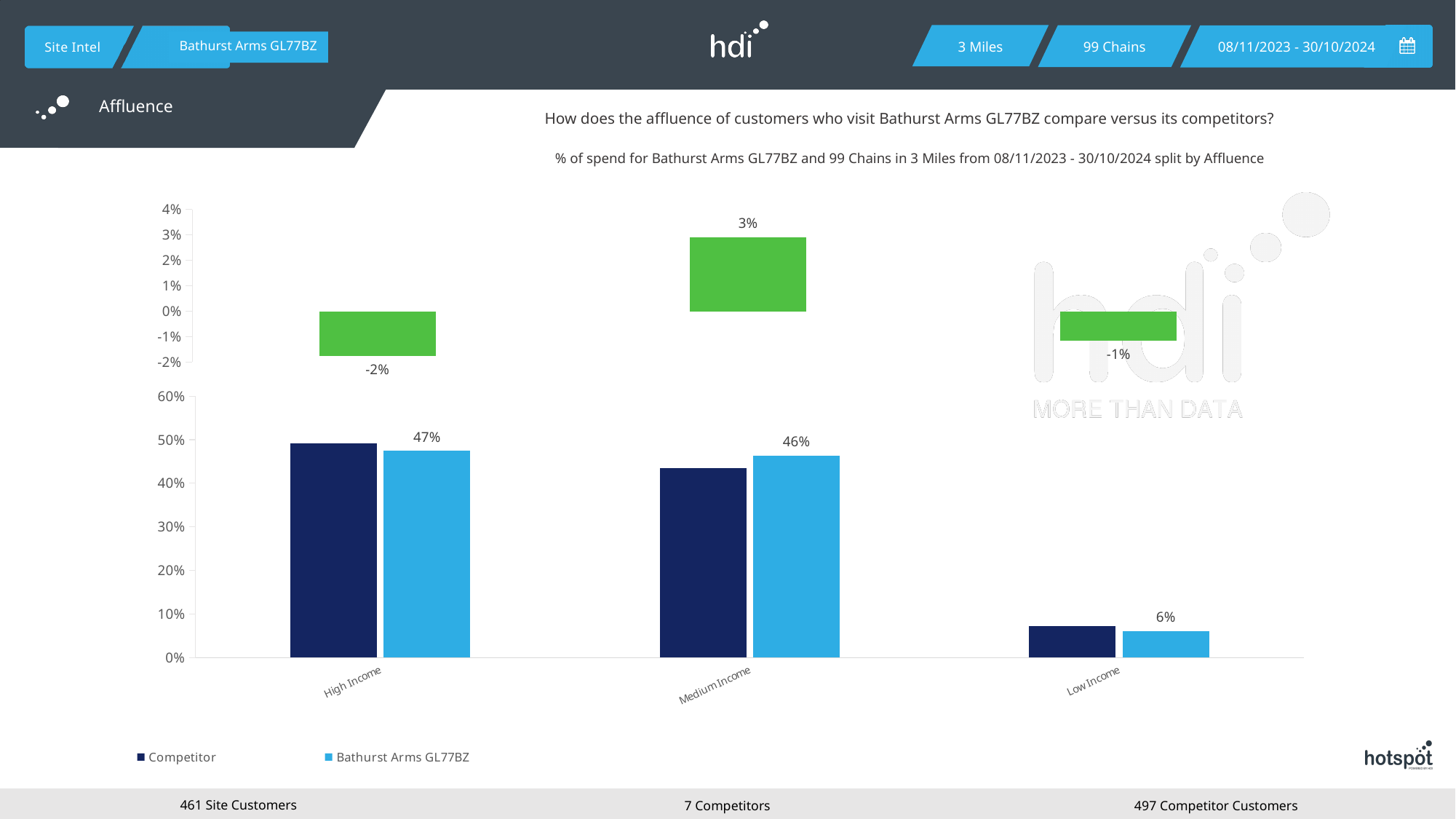
How many categories are shown on the x axis of the bottom bar chart? 3 In the bottom bar chart, is the Competitor value for Low Income greater or less than 10%? less How many series does the legend of the bottom bar chart list? 2 In the bottom bar chart, what is the value for Bathurst Arms GL77BZ in the Medium Income category? 46% In the bottom bar chart, what is the value for Bathurst Arms GL77BZ in the Low Income category? 6% In the bottom bar chart, what is the value for Bathurst Arms GL77BZ in the High Income category? 47% In the top chart, which category has the lowest value? High Income In the bottom bar chart, which category has the lowest value for Bathurst Arms GL77BZ? Low Income In the top chart, what is the value shown for High Income? -2% In the top chart, what is the value shown for Medium Income? 3% In the bottom bar chart, what is the difference between the Bathurst Arms GL77BZ values for High Income and Low Income? 41% In the bottom bar chart, is the Competitor value for High Income greater or less than 40%? greater